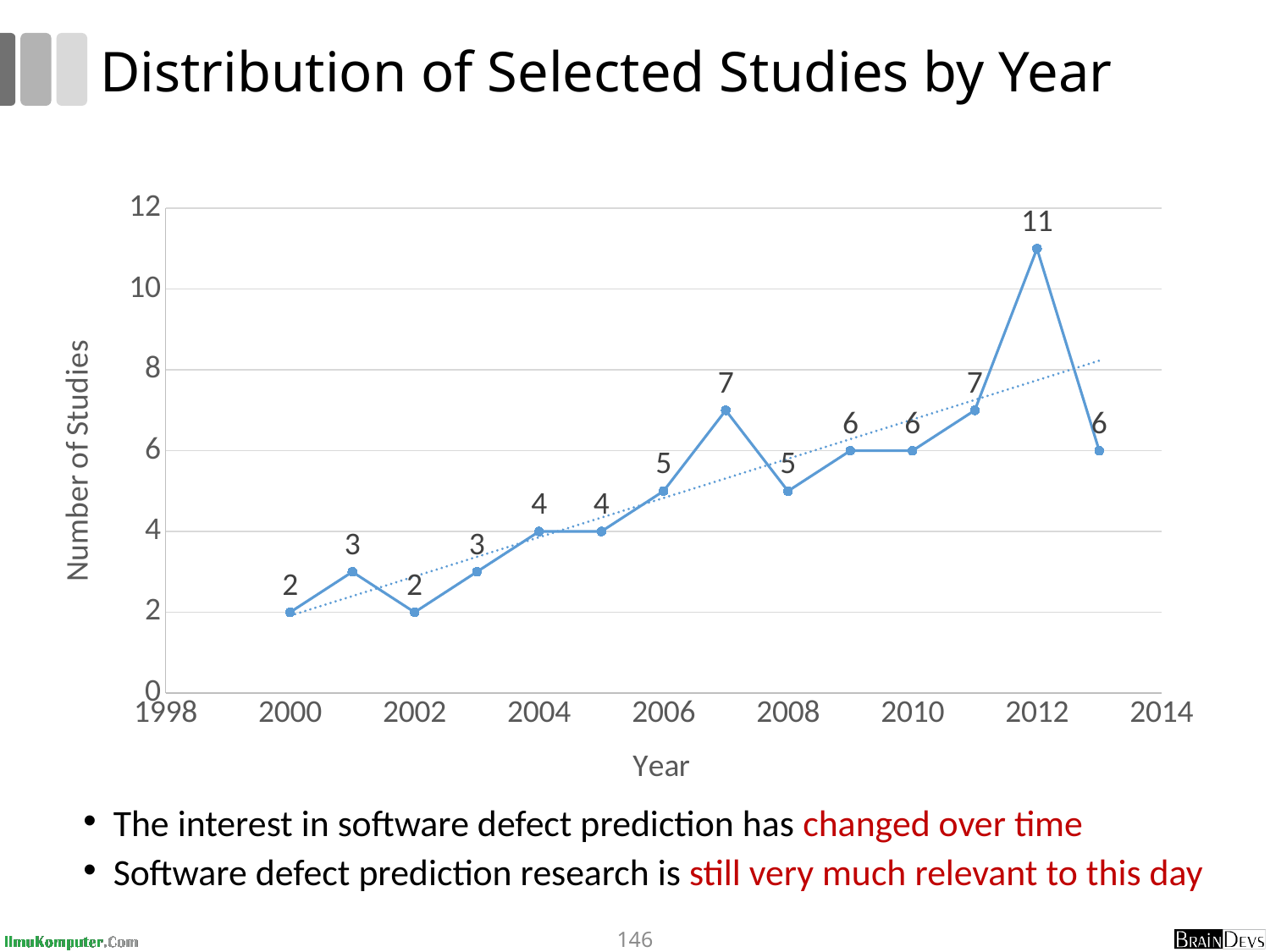
Which year has more studies, 2011 or 2010? 2011 What is the number of studies in 2000? 2 What is the number of studies in 2012? 11 What is the difference in the number of studies between 2007 and 2008? 2 What is the number of studies in 2007? 7 What kind of chart is shown on the slide? line chart How many years are plotted on the chart? 14 What is the label of the y axis? Number of Studies Is the number of studies in 2012 greater or less than 10? greater Which year has the highest number of studies? 2012 Does the number of studies generally rise or fall from 2000 to 2012? rise What is the difference in the number of studies between 2012 and 2013? 5